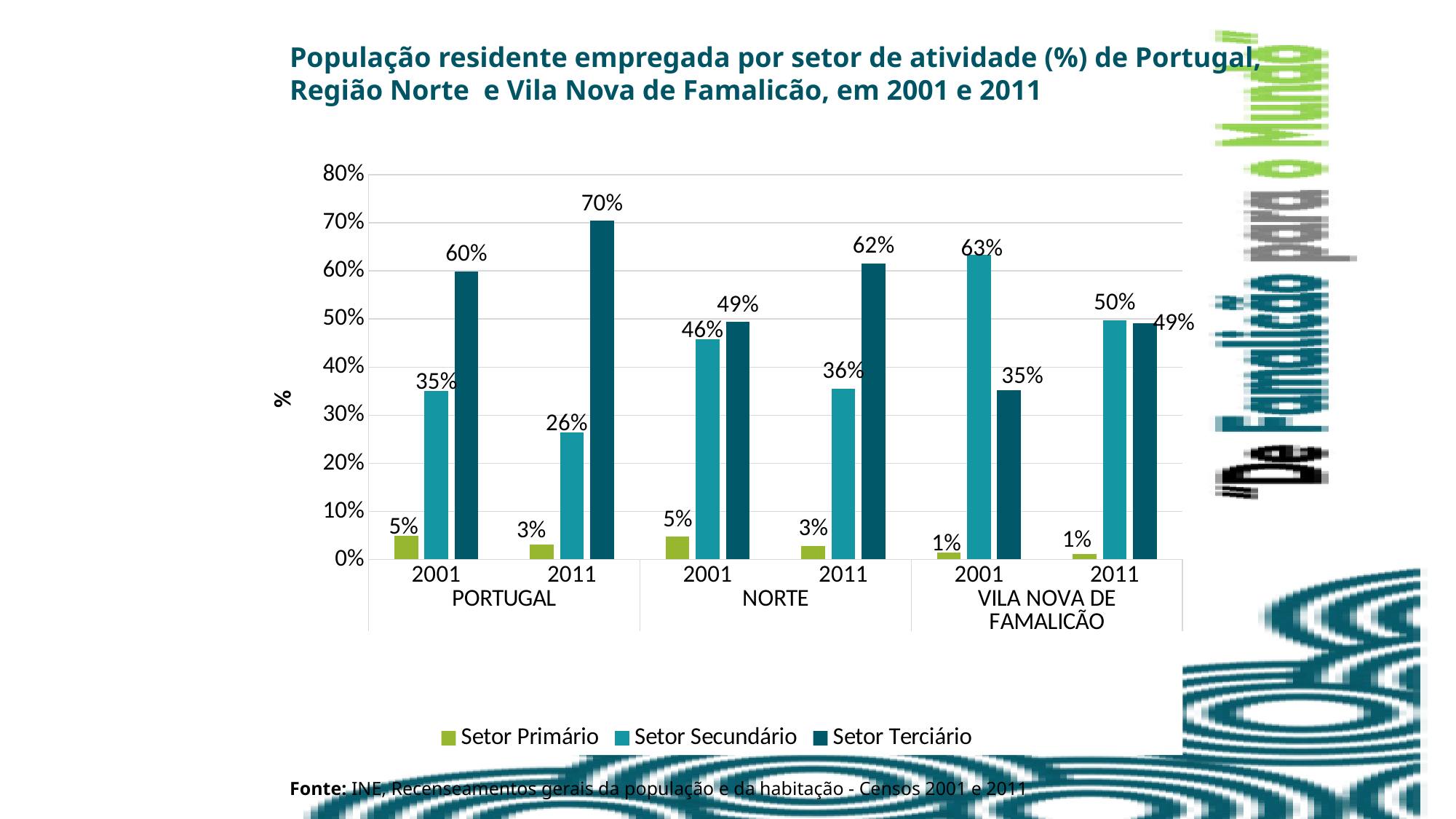
How many region-year groups are shown on the x axis? 6 Which region and year has the lowest Setor Secundário value? Portugal 2011 How many series does the legend list? 3 What is the value for Setor Secundário in Vila Nova de Famalicão in 2001? 63% Does the Setor Secundário value for Portugal rise or fall from 2001 to 2011? fall In Norte in 2001, which is larger: Setor Secundário or Setor Terciário? Setor Terciário What is the difference between the Setor Terciário values for Portugal in 2011 and 2001? 10 percentage points What is the value for Setor Terciário in Portugal in 2011? 70% Which region and year has the highest Setor Terciário value? Portugal 2011 What is the value for Setor Primário in Norte in 2001? 5% Is the value for Setor Terciário in Norte in 2011 greater or less than 60%? greater What kind of chart is shown on the slide? bar chart